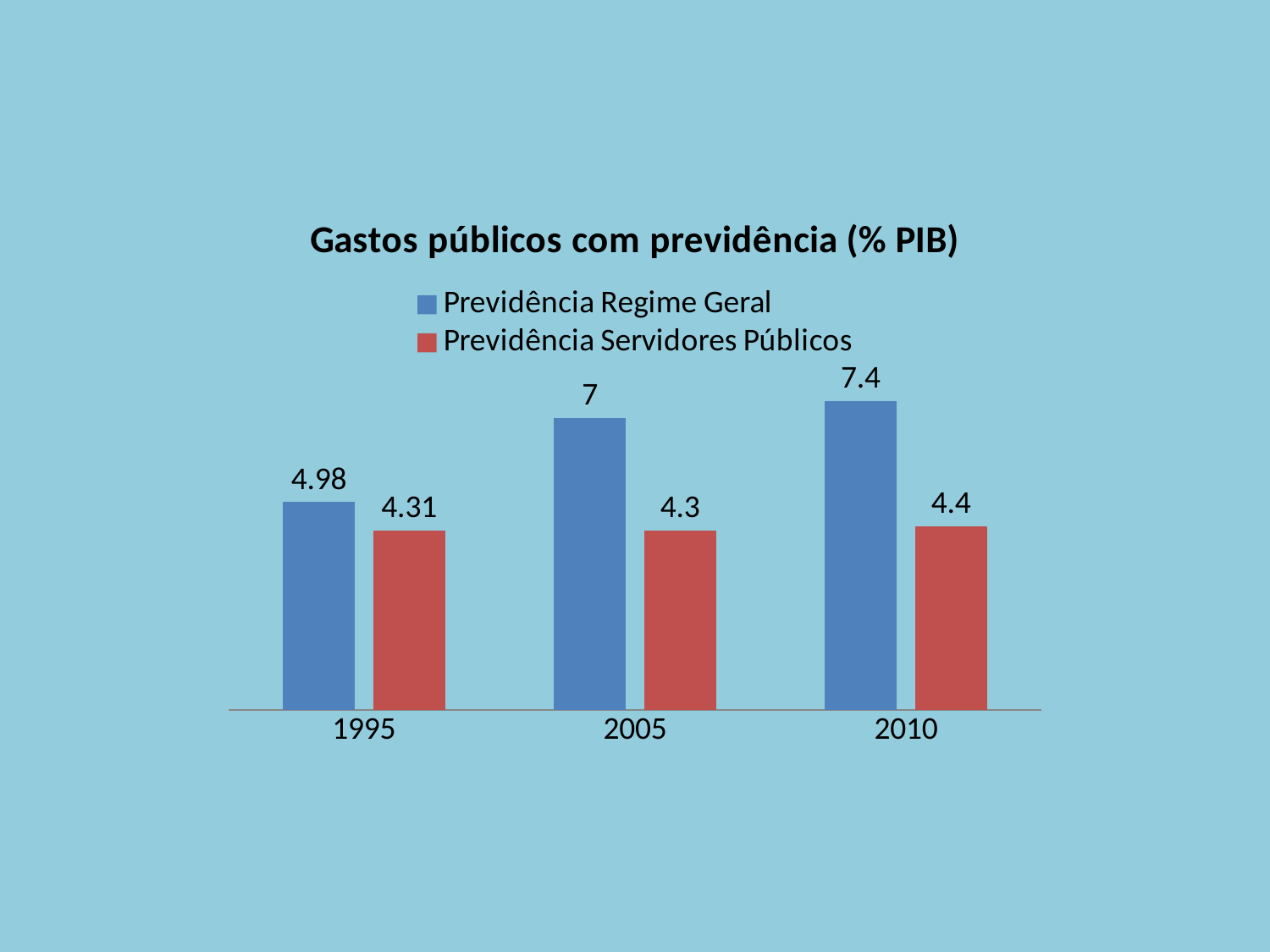
What is the difference between Previdência Regime Geral in 2005 and in 1995? 2.02 What is the value for Previdência Regime Geral in 2010? 7.4 Does the value for Previdência Regime Geral rise or fall from 1995 to 2010? Rise Which is larger in 1995, Previdência Regime Geral or Previdência Servidores Públicos? Previdência Regime Geral In which year is the value for Previdência Servidores Públicos lowest? 2005 What is the value for Previdência Regime Geral in 1995? 4.98 What is the value for Previdência Servidores Públicos in 2005? 4.3 How many years are shown on the x axis? 3 What is the difference between Previdência Regime Geral and Previdência Servidores Públicos in 2010? 3 What kind of chart is shown on the slide? Bar chart How many series does the legend list? 2 In which year is the value for Previdência Regime Geral highest? 2010